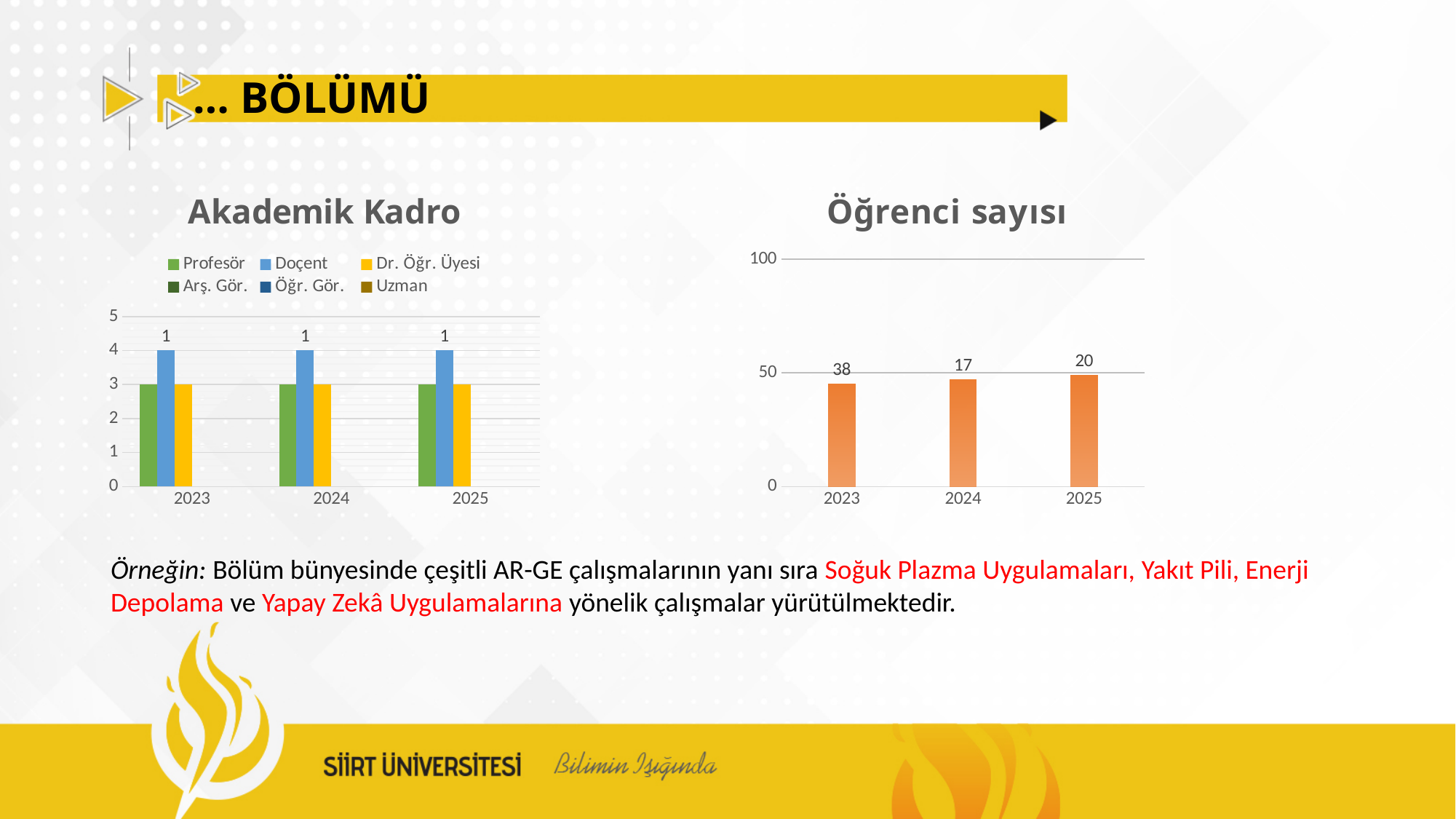
How many series does the legend of the "Akademik Kadro" chart list? 6 In the "Akademik Kadro" chart, what is the value for Profesör in 2024? 3 In the "Akademik Kadro" chart, which colour represents Dr. Öğr. Üyesi? yellow In the "Öğrenci sayısı" chart, is the value for 2023 greater or less than 50? less In the "Öğrenci sayısı" chart, which is larger, the value for 2024 or the value for 2025? 2025 How many years are shown on the x axis of the "Öğrenci sayısı" chart? 3 What kind of chart is the "Öğrenci sayısı" chart? bar chart